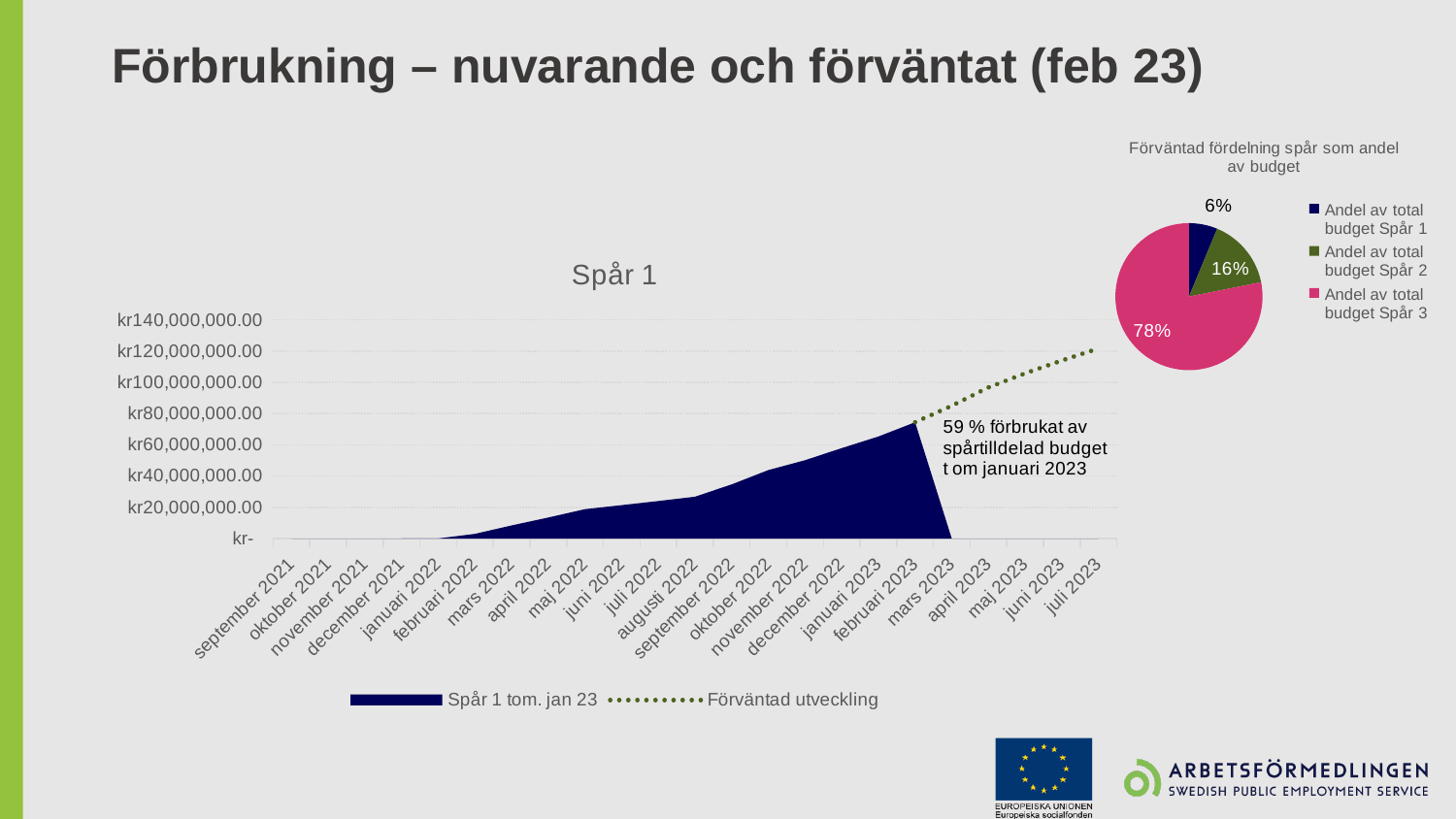
In the 'Spår 1' chart, does the plotted consumption rise or fall from september 2021 to januari 2023? Rise How many entries does the legend of the pie chart 'Förväntad fördelning spår som andel av budget' list? 3 In the 'Spår 1' chart, is the value for januari 2023 greater or less than kr40,000,000.00? greater According to the annotation on the 'Spår 1' chart, what percentage of the track-allocated budget had been consumed up to januari 2023? 59 % In the pie chart 'Förväntad fördelning spår som andel av budget', what share is 'Andel av total budget Spår 1'? 6% In the pie chart 'Förväntad fördelning spår som andel av budget', what share is 'Andel av total budget Spår 2'? 16% In the pie chart 'Förväntad fördelning spår som andel av budget', what is the difference in percentage points between Spår 3 and Spår 2? 62 percentage points In the pie chart 'Förväntad fördelning spår som andel av budget', which slice is the smallest? Andel av total budget Spår 1 What kind of chart is the 'Spår 1' chart on the left? Area chart In the pie chart 'Förväntad fördelning spår som andel av budget', what share is 'Andel av total budget Spår 3'? 78% In the pie chart 'Förväntad fördelning spår som andel av budget', which slice is the largest? Andel av total budget Spår 3 How many entries does the legend of the 'Spår 1' chart list? 2